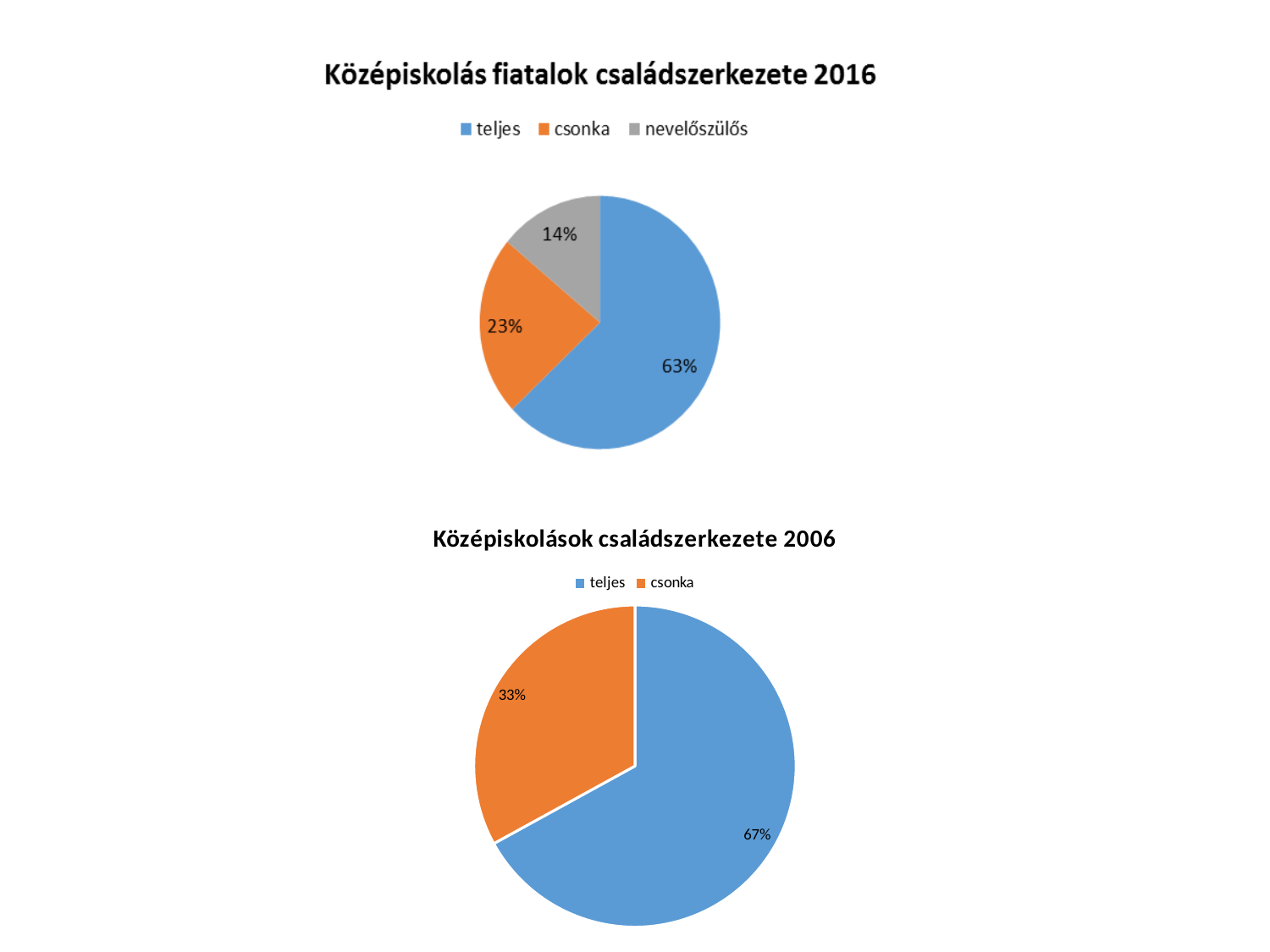
In the chart titled 'Középiskolások családszerkezete 2006', how many categories does the legend list? 2 In the chart titled 'Középiskolás fiatalok családszerkezete 2016', what share of the pie is 'nevelőszülős'? 14% In the chart titled 'Középiskolás fiatalok családszerkezete 2016', what share of the pie is 'teljes'? 63% What kind of chart is the chart titled 'Középiskolások családszerkezete 2006'? Pie chart In the chart titled 'Középiskolás fiatalok családszerkezete 2016', what is the difference in percentage points between 'csonka' and 'nevelőszülős'? 9 percentage points In the chart titled 'Középiskolás fiatalok családszerkezete 2016', which category has the largest slice? teljes In the chart titled 'Középiskolás fiatalok családszerkezete 2016', how many categories does the legend list? 3 In the chart titled 'Középiskolások családszerkezete 2006', what share of the pie is 'teljes'? 67% In the chart titled 'Középiskolás fiatalok családszerkezete 2016', which category has the smallest slice? nevelőszülős Which is larger: the 'teljes' share in the 2016 chart or the 'teljes' share in the 2006 chart? The 2006 chart (67%)